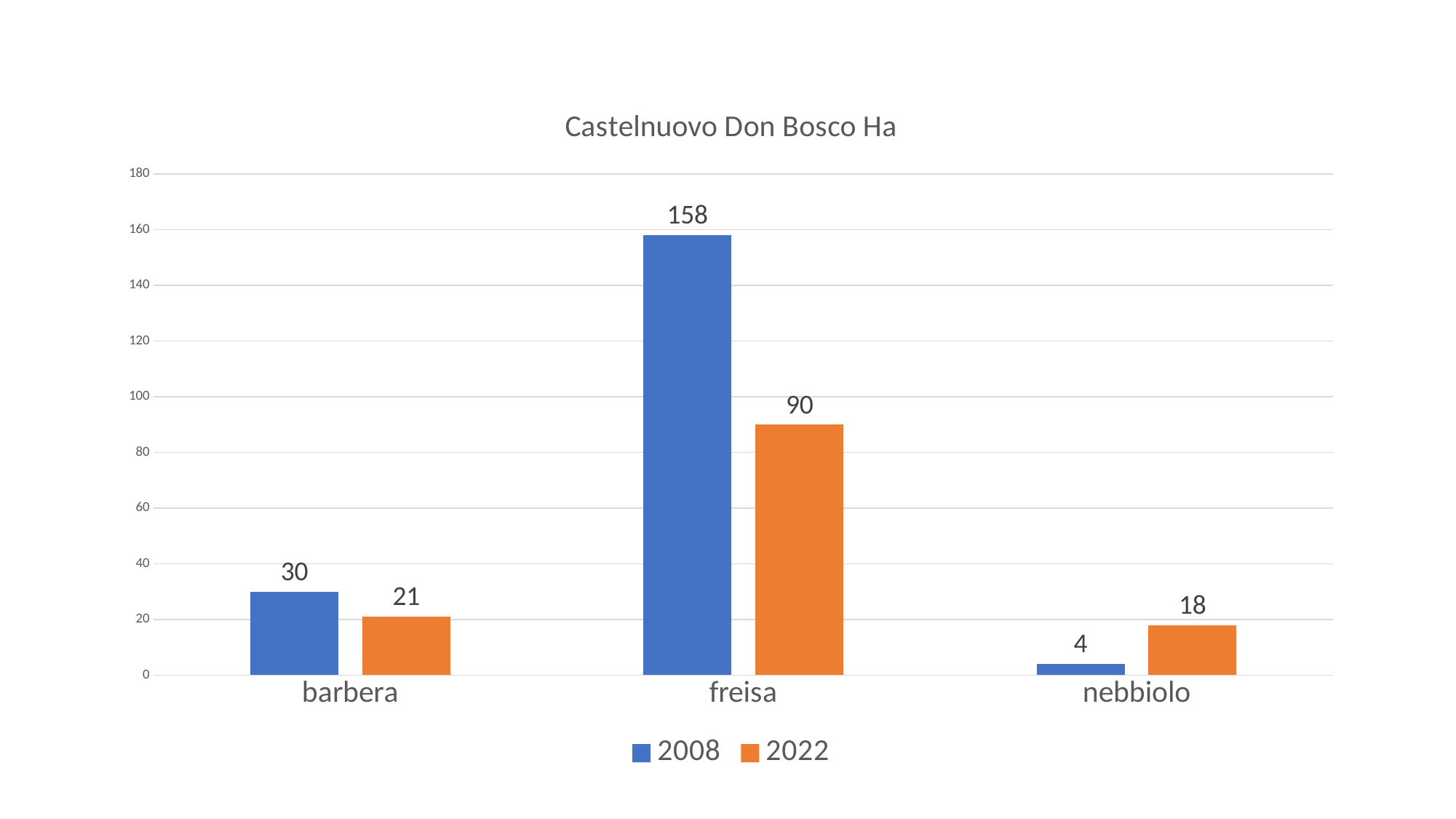
What is the difference between the 2008 and 2022 values for freisa? 68 What is the title of the chart? Castelnuovo Don Bosco Ha How many categories are shown on the x axis? 3 What is the value for nebbiolo in 2022? 18 What is the value for freisa in 2008? 158 What kind of chart is shown on the slide? bar chart What is the value for barbera in 2022? 21 Is the value for freisa in 2022 greater or less than 100? less Which category has the highest value in 2008? freisa How many series does the legend list? 2 Which category has the lowest value in 2022? nebbiolo Which is larger for nebbiolo, the 2008 value or the 2022 value? 2022